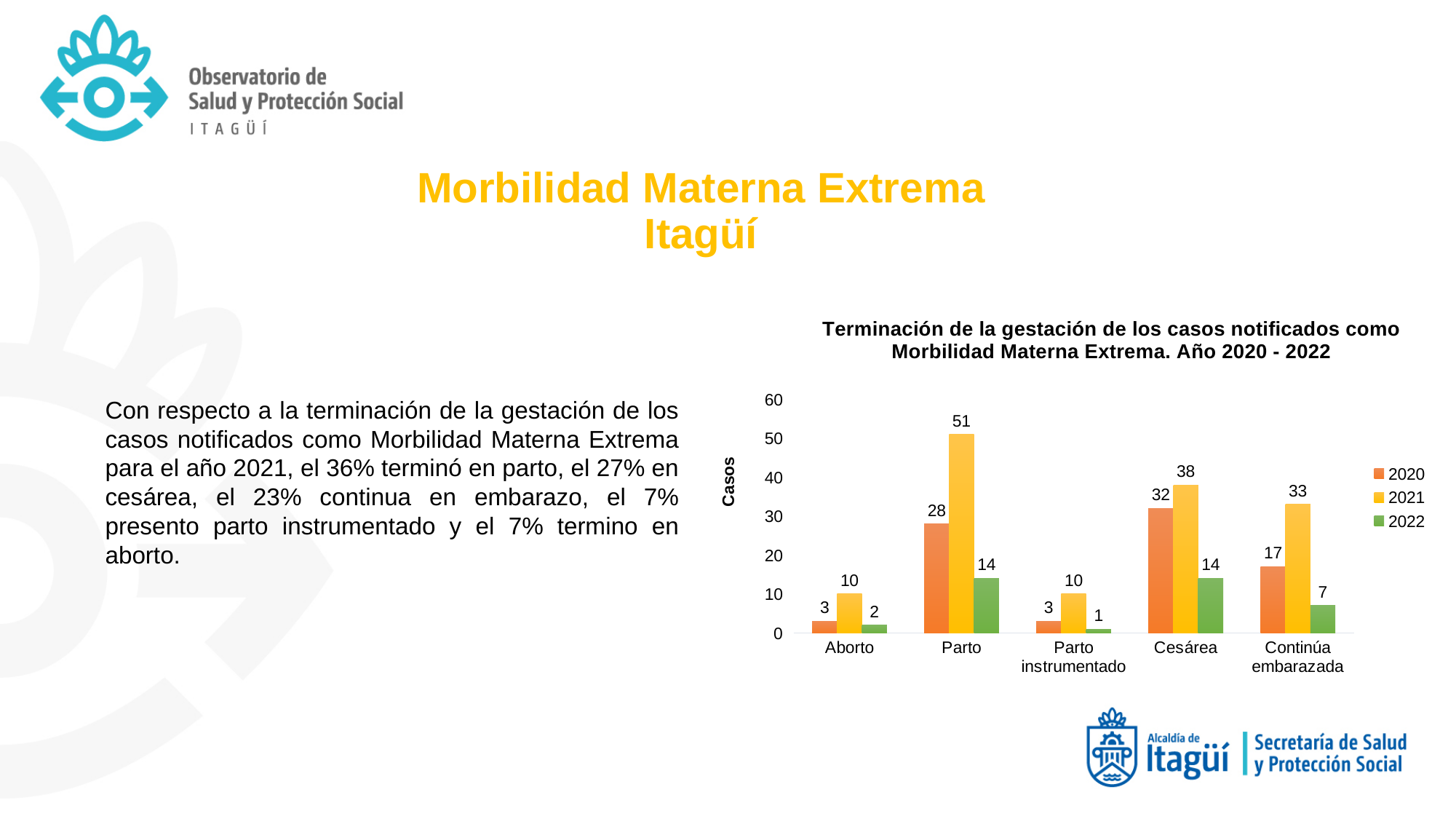
What is the label of the vertical axis? Casos How many series does the legend list? 3 Which is larger: the 2020 value for Cesárea or the 2020 value for Parto? Cesárea What is the value for Cesárea in 2020? 32 Which category has the highest value for 2021? Parto What kind of chart is shown? Bar chart How many categories are shown on the x axis? 5 Which category has the lowest value for 2022? Parto instrumentado Which year is represented by the green bars? 2022 What is the difference between the 2021 and 2020 values for Parto? 23 What is the value for Parto in 2021? 51 What is the value for Continúa embarazada in 2022? 7